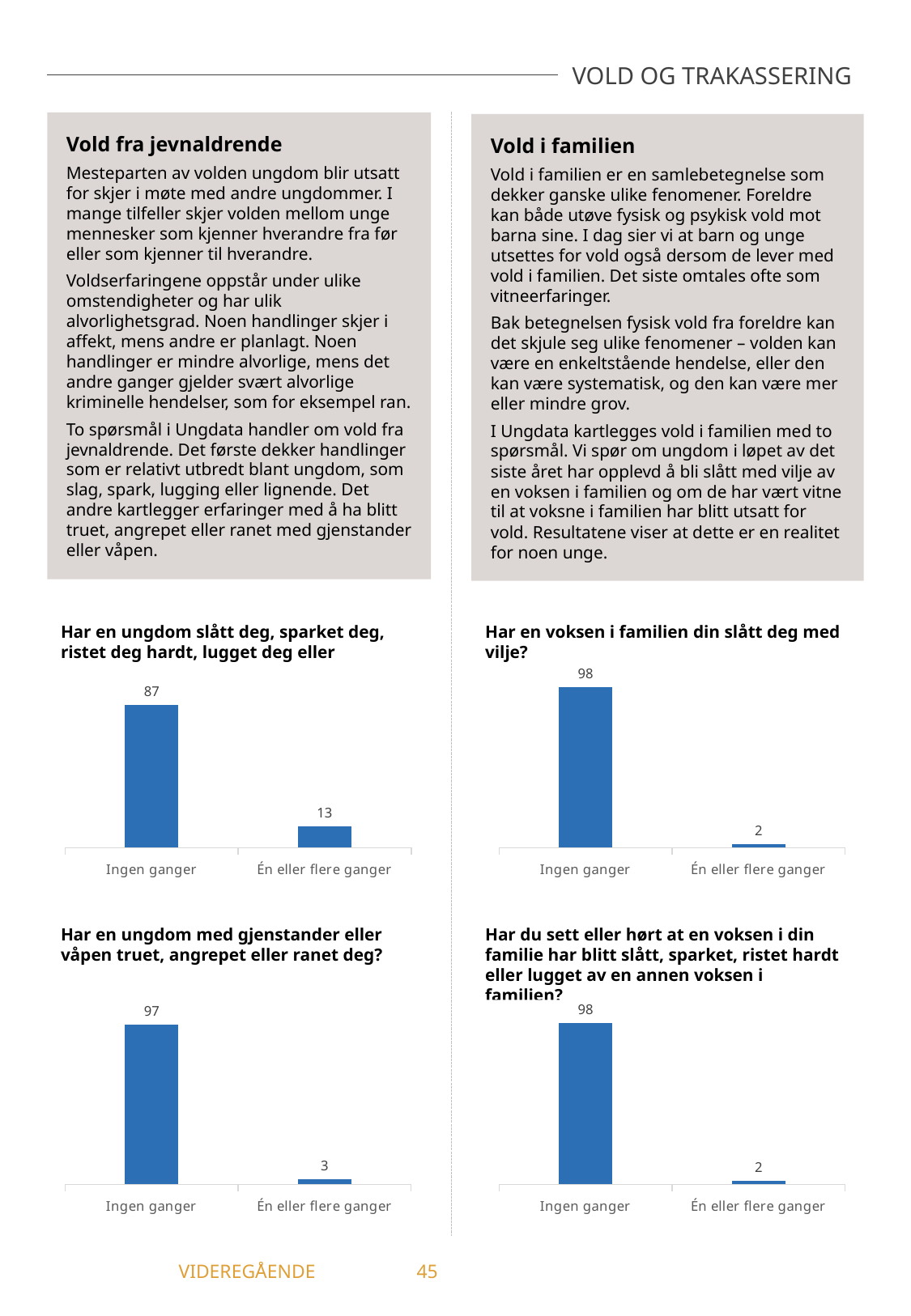
Which chart on the slide has the highest value for "Én eller flere ganger"? Har en ungdom slått deg, sparket deg, ristet deg hardt, lugget deg eller In the top-right chart ("Har en voksen i familien din slått deg med vilje?"), what is the value for "Ingen ganger"? 98 In the bottom-right chart ("Har du sett eller hørt at en voksen i din familie har blitt slått..."), what is the difference between the two bars? 96 What type of chart is the bottom-left chart ("Har en ungdom med gjenstander eller våpen truet, angrepet eller ranet deg?")? Bar chart In the bottom-left chart ("Har en ungdom med gjenstander eller våpen truet, angrepet eller ranet deg?"), what is the value for "Én eller flere ganger"? 3 How many categories does the top-right chart ("Har en voksen i familien din slått deg med vilje?") show? 2 In the bottom-right chart ("Har du sett eller hørt at en voksen i din familie har blitt slått..."), what is the value for "Ingen ganger"? 98 In the top-right chart ("Har en voksen i familien din slått deg med vilje?"), what is the value for "Én eller flere ganger"? 2 In the top-left chart ("Har en ungdom slått deg, sparket deg..."), what is the value for "Én eller flere ganger"? 13 In the top-left chart ("Har en ungdom slått deg, sparket deg, ristet deg hardt, lugget deg eller"), what is the value for "Ingen ganger"? 87 In the top-left chart ("Har en ungdom slått deg, sparket deg..."), what is the difference between the "Ingen ganger" and "Én eller flere ganger" values? 74 In the bottom-left chart ("Har en ungdom med gjenstander eller våpen truet, angrepet eller ranet deg?"), which category has the highest value? Ingen ganger